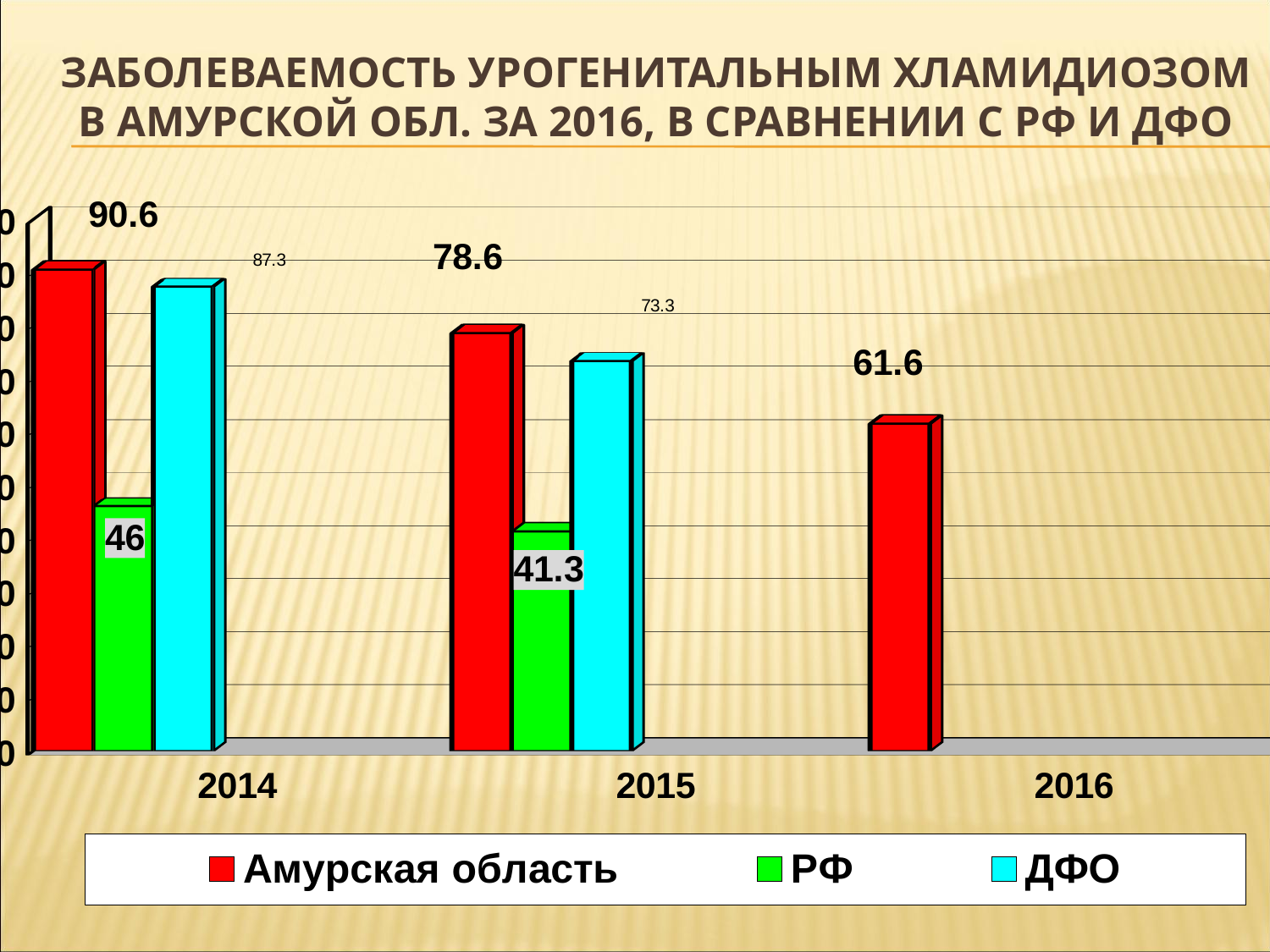
Which series has the lowest value in 2015? РФ What is the value for Амурская область in 2014? 90.6 How many series does the legend list? 3 What is the value for Амурская область in 2016? 61.6 What is the value for ДФО in 2014? 87.3 Which is larger in 2015: the value for Амурская область or the value for ДФО? Амурская область What is the value for ДФО in 2015? 73.3 What is the value for РФ in 2015? 41.3 What kind of chart is shown on the slide? Bar chart What is the difference between the Амурская область value and the РФ value in 2014? 44.6 Do the values for Амурская область rise or fall from 2014 to 2016? Fall In which year is the value for Амурская область the highest? 2014